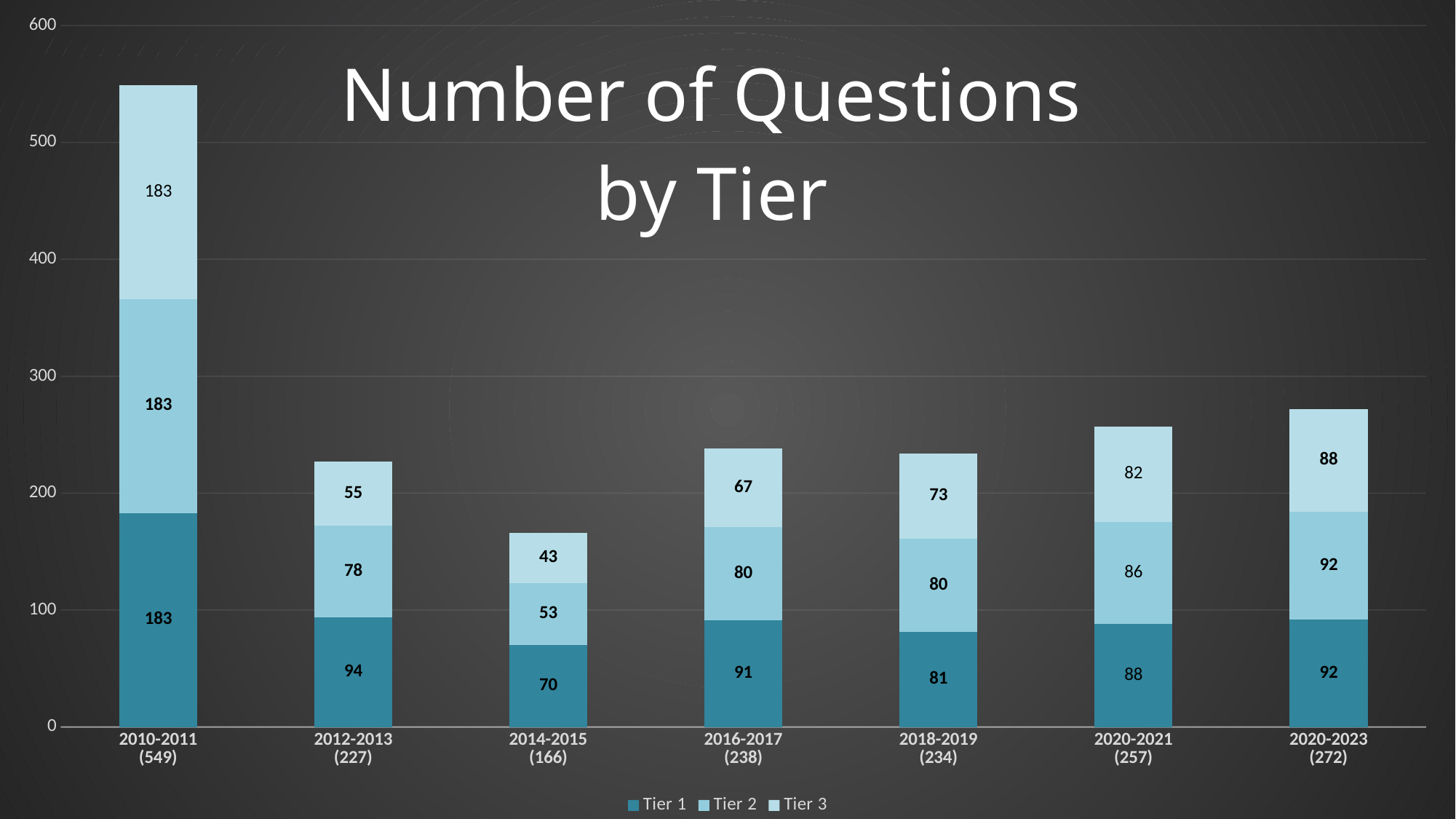
How many series does the legend list? 3 What is the Tier 2 value for 2016-2017? 80 What kind of chart is shown? stacked bar chart Which period has the lowest total number of questions? 2014-2015 Which period has the highest total number of questions? 2010-2011 What is the Tier 1 value for 2014-2015? 70 Is the total for 2020-2023 greater or less than 300? less How many periods are shown on the x axis? 7 Which is larger, the Tier 3 value for 2018-2019 or the Tier 3 value for 2020-2021? 2020-2021 What is the difference between the Tier 1 values for 2012-2013 and 2014-2015? 24 What is the Tier 3 value for 2020-2023? 88 What is the total of the stacked bar for 2016-2017? 238